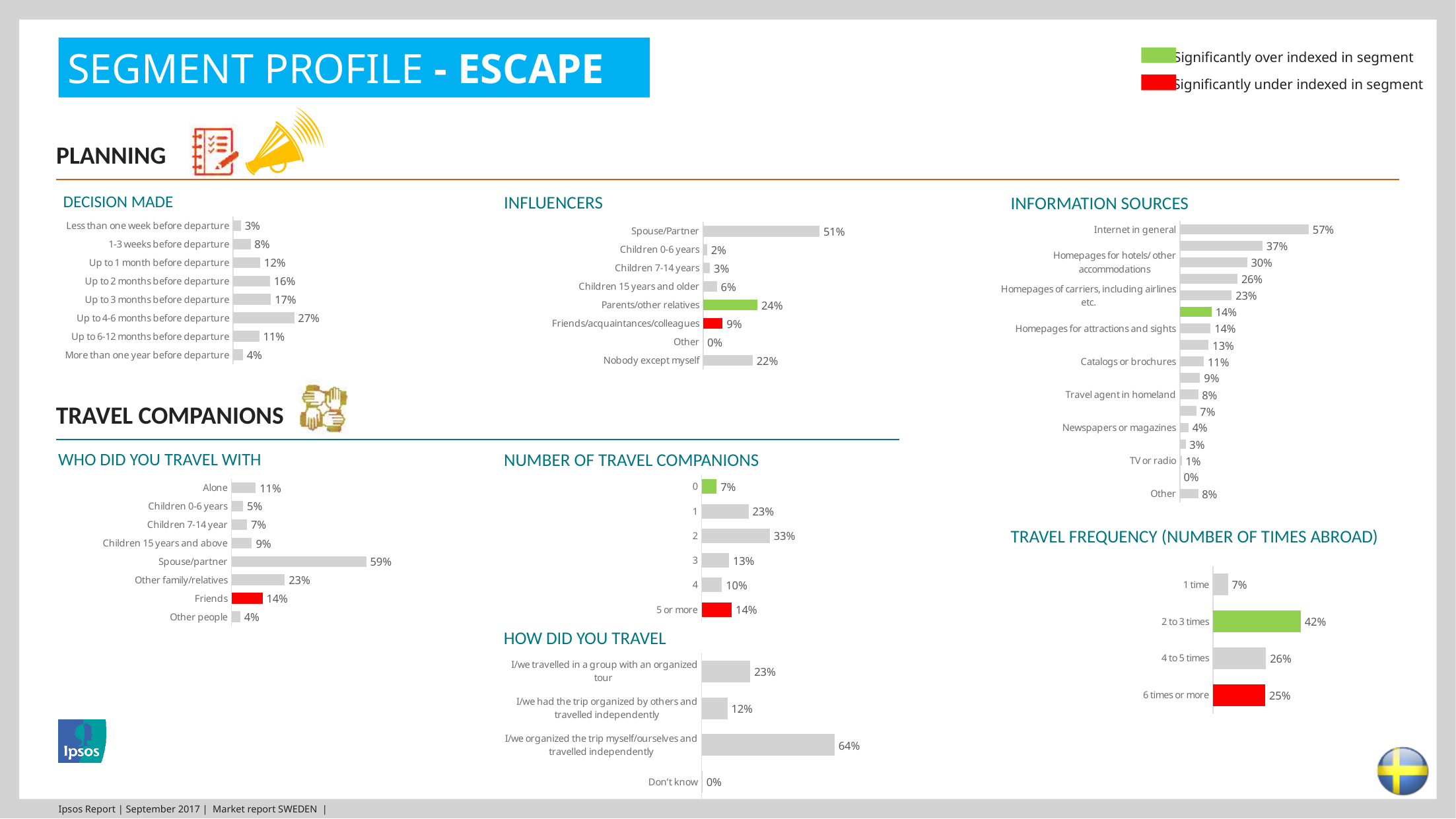
In the HOW DID YOU TRAVEL chart, what is the value for 'I/we organized the trip myself/ourselves and travelled independently'? 64% In the INFLUENCERS chart, what is the value for 'Parents/other relatives'? 24% In the DECISION MADE chart, which category has the lowest value? Less than one week before departure In the WHO DID YOU TRAVEL WITH chart, how many categories are shown? 8 In the TRAVEL FREQUENCY (NUMBER OF TIMES ABROAD) chart, which category has the highest value? 2 to 3 times In the NUMBER OF TRAVEL COMPANIONS chart, what is the value for '2'? 33% In the WHO DID YOU TRAVEL WITH chart, which is larger: 'Other family/relatives' or 'Friends'? Other family/relatives In the DECISION MADE chart, what is the value for 'Up to 4-6 months before departure'? 27% In the INFLUENCERS chart, which category has the highest value? Spouse/Partner In the INFORMATION SOURCES chart, what is the value for 'Catalogs or brochures'? 11% In the INFLUENCERS chart, what is the difference between 'Spouse/Partner' and 'Nobody except myself'? 29% In the INFORMATION SOURCES chart, what is the value for 'Internet in general'? 57%